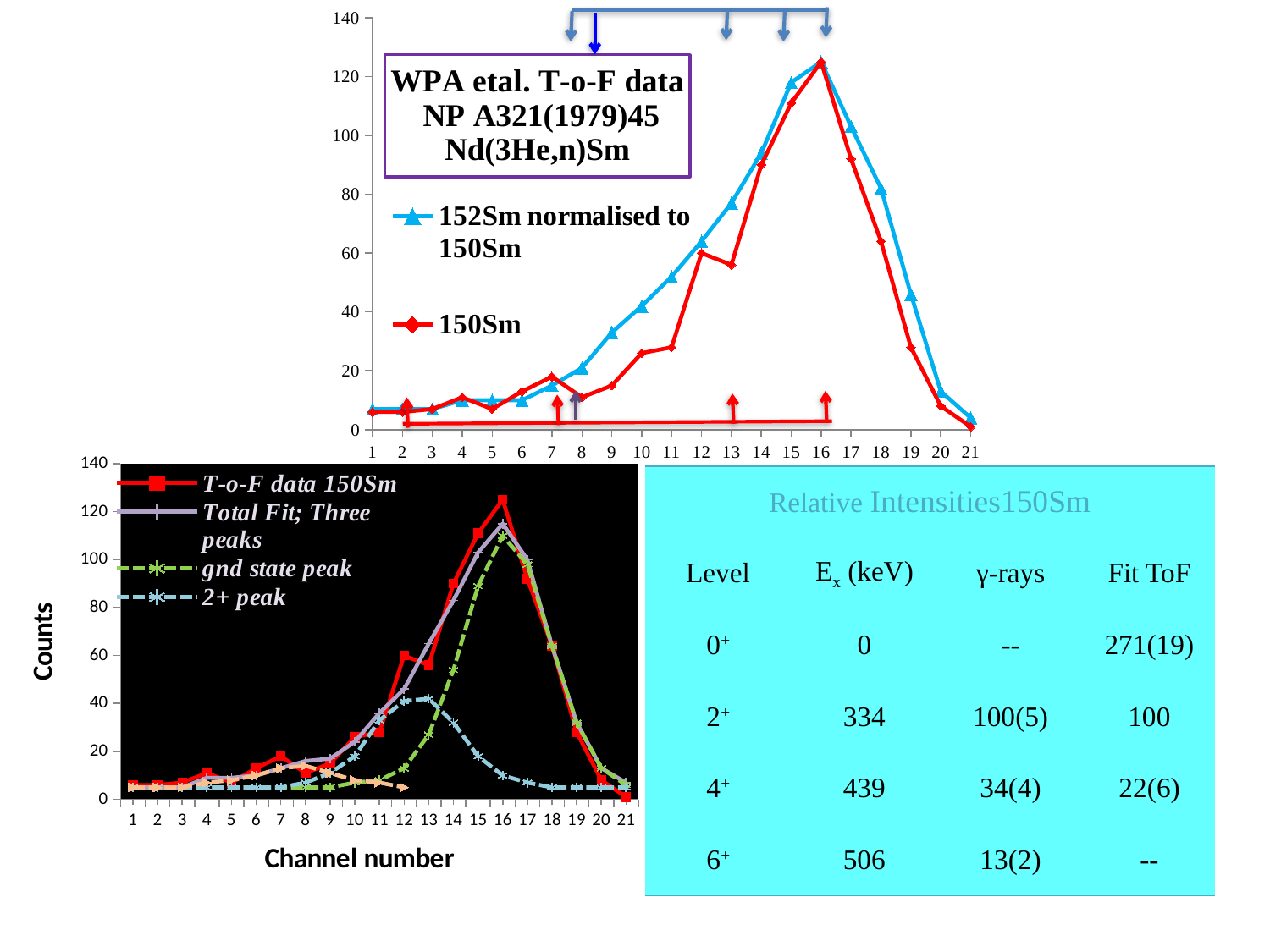
What kind of chart is the top chart? line chart On the top chart, is the value of 150Sm at channel 20 greater or less than 20? less On the top chart, at channel 11, which series has the larger value, 152Sm normalised to 150Sm or 150Sm? 152Sm normalised to 150Sm On the top chart, do the 150Sm values rise or fall from channel 16 to channel 21? fall On the bottom chart, how many series does the legend list? 4 On the top chart, is the value of 150Sm at channel 16 greater or less than 120? greater On the bottom chart, is the value of T-o-F data 150Sm at channel 16 greater or less than 120? greater On the top chart, at which channel number does the 150Sm series reach its highest value? 16 On the top chart, how many channel numbers are shown on the x axis? 21 On the top chart, how many series does the legend list? 2 What is the x-axis title of the bottom chart? Channel number